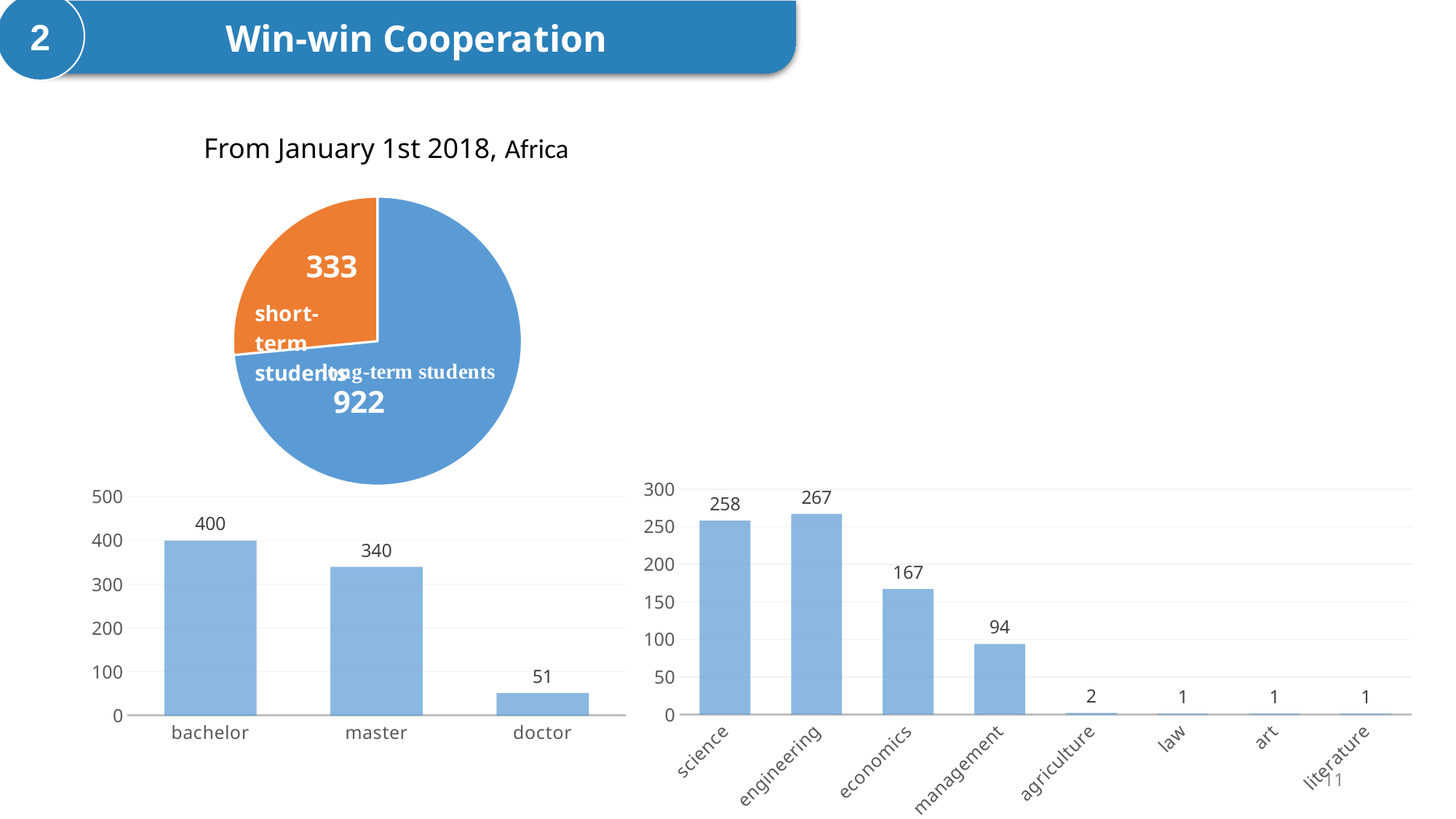
In the bottom-left bar chart, how many categories are shown? 3 In the bottom-left bar chart, what is the difference between bachelor and doctor? 349 In the bottom-left bar chart, which category has the lowest value? doctor In the bottom-right bar chart, which category has the highest value? engineering In the pie chart, which slice is larger, short-term students or long-term students? long-term students In the bottom-left bar chart, what is the value for master? 340 In the pie chart, what is the total number of students across both slices? 1255 In the bottom-right bar chart, what is the difference between engineering and science? 9 In the bottom-right bar chart, what is the value for economics? 167 In the pie chart, how many short-term students are there? 333 In the bottom-right bar chart, how many categories are shown on the x axis? 8 In the pie chart, how many long-term students are there? 922